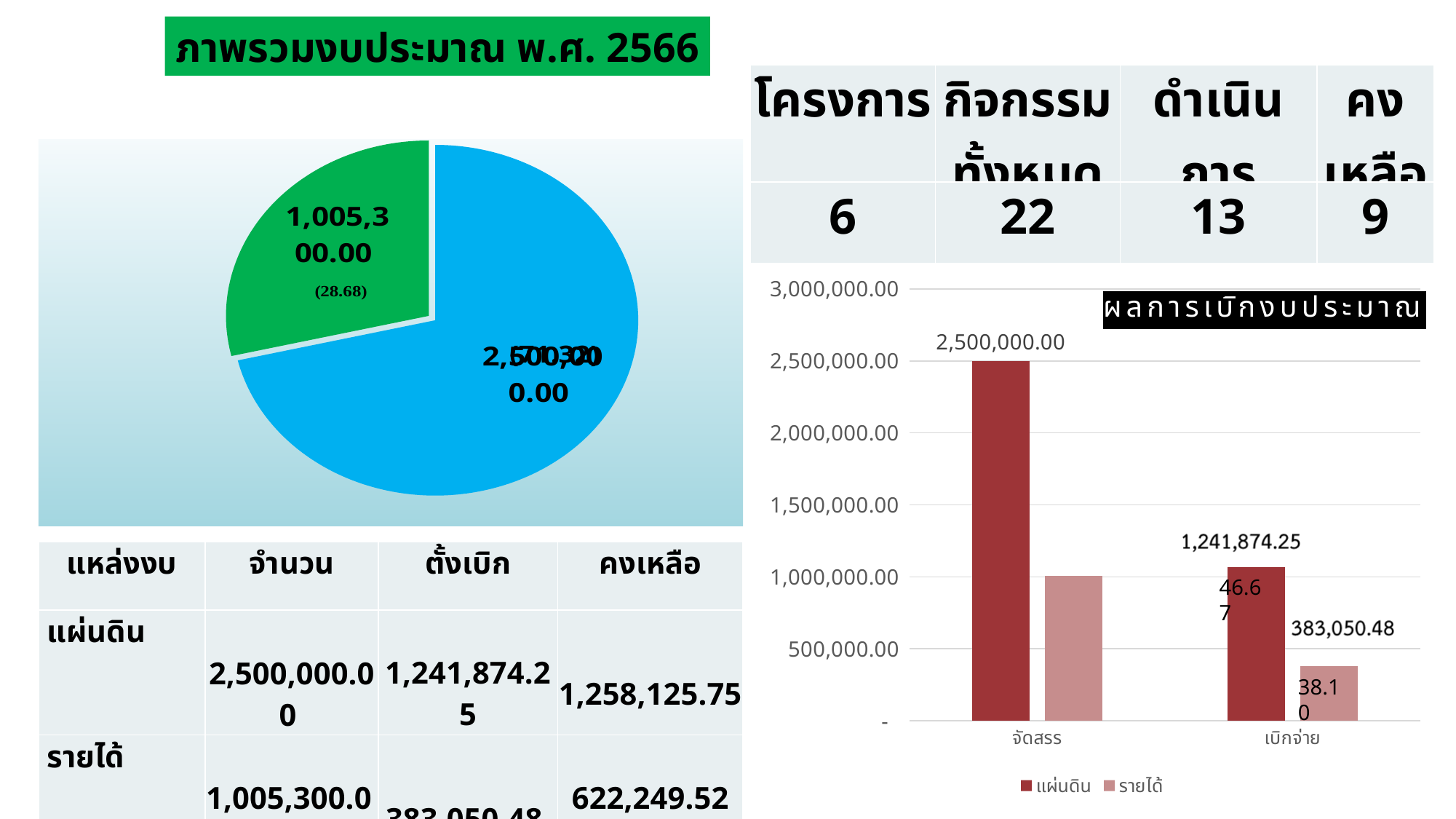
In the pie chart on the left, what value is printed on the green slice? 1,005,300.00 In the chart titled ผลการเบิกงบประมาณ, which bar is the tallest? แผ่นดิน for จัดสรร In the pie chart on the left, which slice is larger, the green one or the blue one? the blue one In the chart titled ผลการเบิกงบประมาณ, what is the value of รายได้ for เบิกจ่าย? 383,050.48 In the chart titled ผลการเบิกงบประมาณ, how many series does the legend list? 2 What kind of chart is the chart titled ผลการเบิกงบประมาณ on the right of the slide? bar chart In the chart titled ผลการเบิกงบประมาณ, is the value of รายได้ for จัดสรร greater or less than 1,500,000.00? less How many slices does the pie chart on the left have? 2 In the chart titled ผลการเบิกงบประมาณ, what is the value of แผ่นดิน for จัดสรร? 2,500,000.00 In the pie chart on the left, what share is printed on the green slice? 28.68 In the chart titled ผลการเบิกงบประมาณ, what is the difference between the แผ่นดิน value for จัดสรร (2,500,000.00) and the แผ่นดิน value for เบิกจ่าย (1,241,874.25)? 1,258,125.75 What kind of chart is the chart on the left of the slide, under the title ภาพรวมงบประมาณ พ.ศ. 2566? pie chart